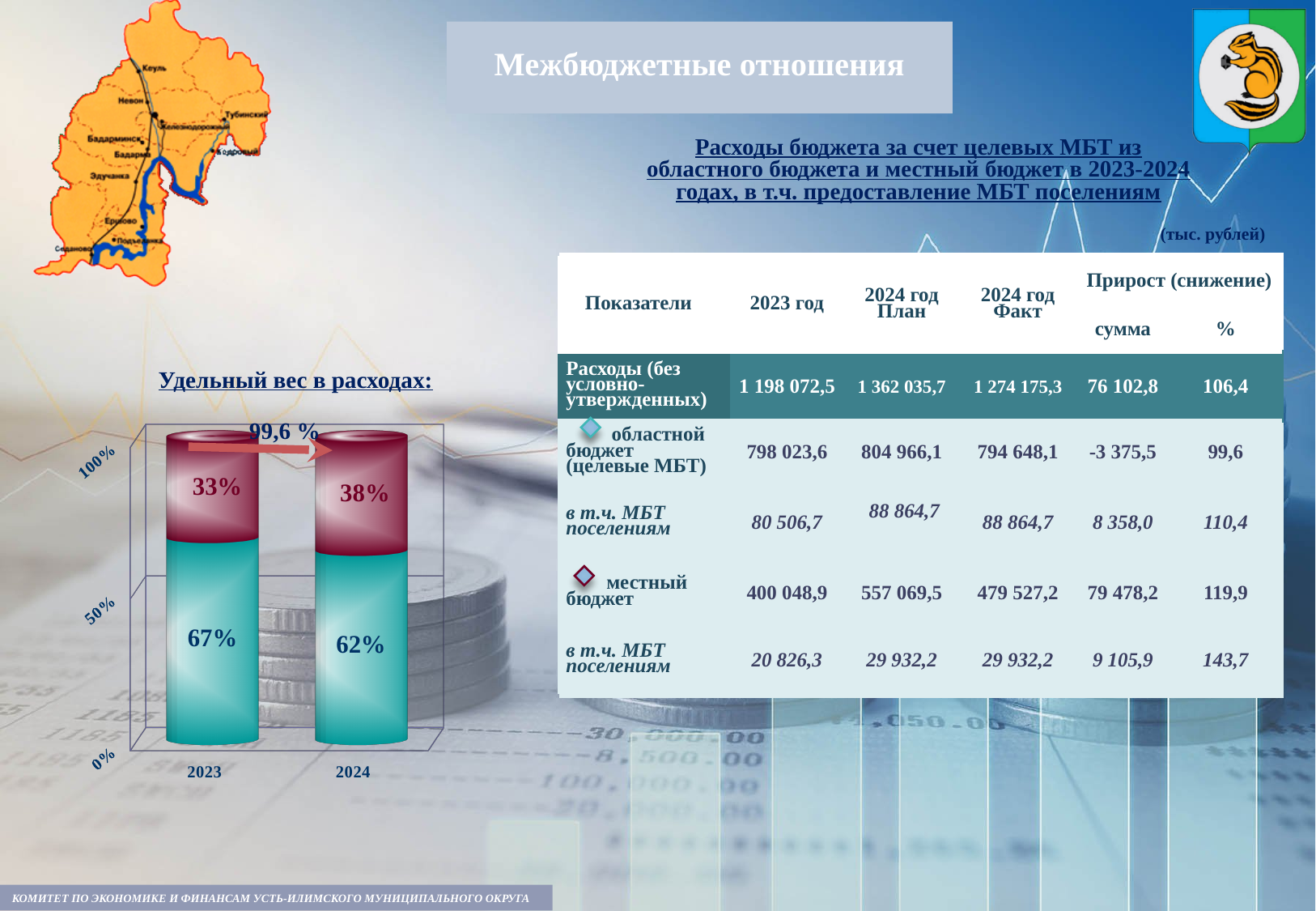
In the "Удельный вес в расходах" chart, what is the total of the two segments of the 2023 bar? 100% In the "Удельный вес в расходах" chart, which year has the larger red (top) segment, 2023 or 2024? 2024 In the "Удельный вес в расходах" chart, what is the value of the bottom teal segment for 2024? 62% How many bars (years) does the "Удельный вес в расходах" chart show? 2 What percentage label is printed above the arrow between the two bars in the "Удельный вес в расходах" chart? 99,6 % What kind of chart is shown under the heading "Удельный вес в расходах"? bar chart In the "Удельный вес в расходах" chart, what is the value of the bottom teal segment for 2023? 67% In the "Удельный вес в расходах" chart, is the teal segment for 2023 greater or less than 50%? greater In the "Удельный вес в расходах" chart, what is the value of the top red segment for 2023? 33% In the "Удельный вес в расходах" chart, by how many percentage points does the teal segment differ between 2023 and 2024? 5 In the "Удельный вес в расходах" chart, what is the value of the top red segment for 2024? 38% In the "Удельный вес в расходах" chart, does the teal (bottom) segment rise or fall from 2023 to 2024? fall